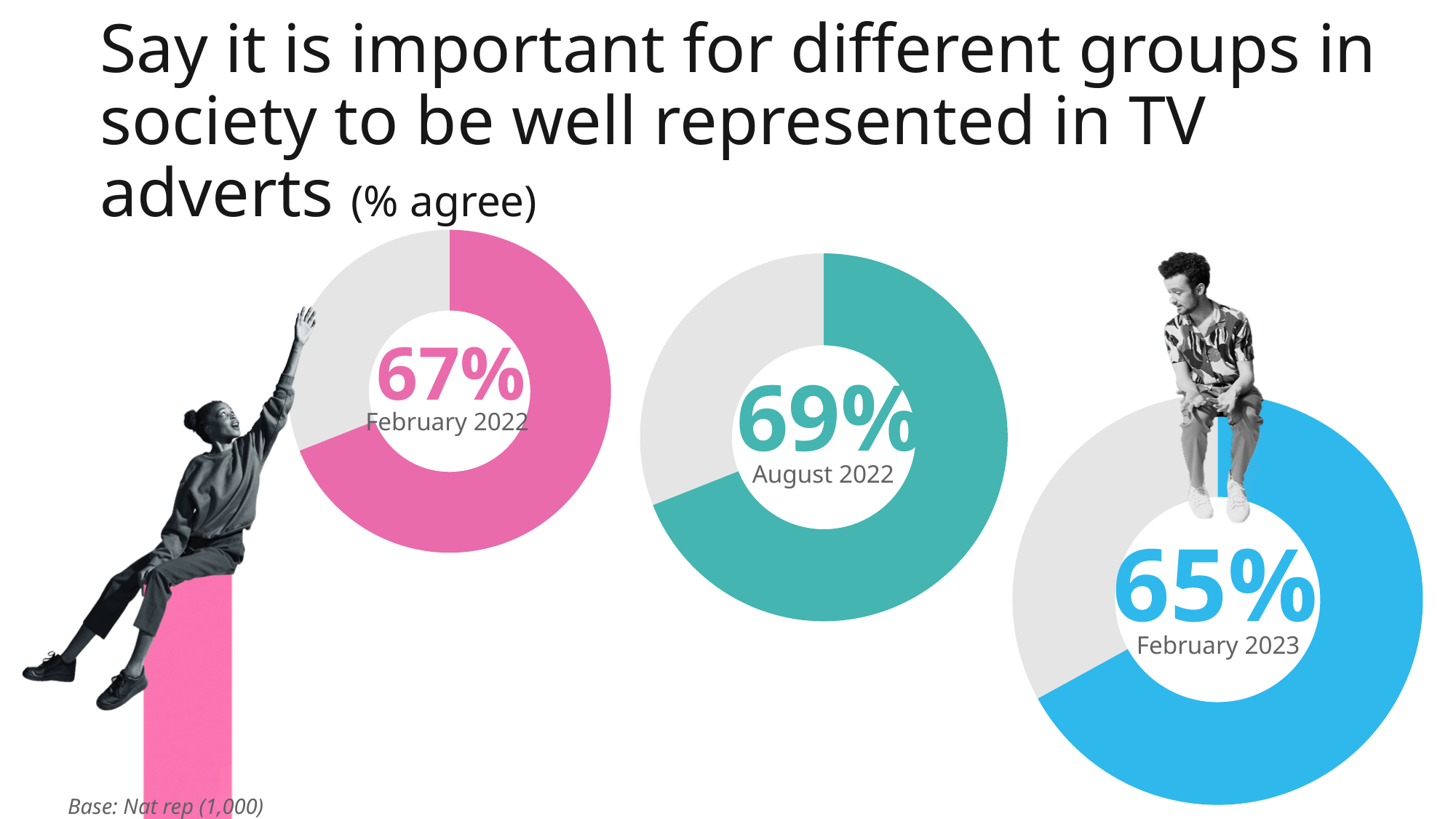
Which survey wave has the lowest percentage agreeing? February 2023 What percentage agreed in August 2022? 69% What percentage agreed in February 2023? 65% What percentage agreed in February 2022? 67% Which survey wave has the highest percentage agreeing? August 2022 Which is larger, the value for February 2022 or the value for February 2023? February 2022 What colour is the filled segment of the February 2023 donut chart? Blue What kind of chart is used to show each survey wave's result? Donut (pie) chart What is the difference in percentage points between August 2022 and February 2023? 4 What is the difference in percentage points between February 2022 and August 2022? 2 Did the percentage agreeing rise or fall from August 2022 to February 2023? Fall How many donut charts are shown on the slide? 3